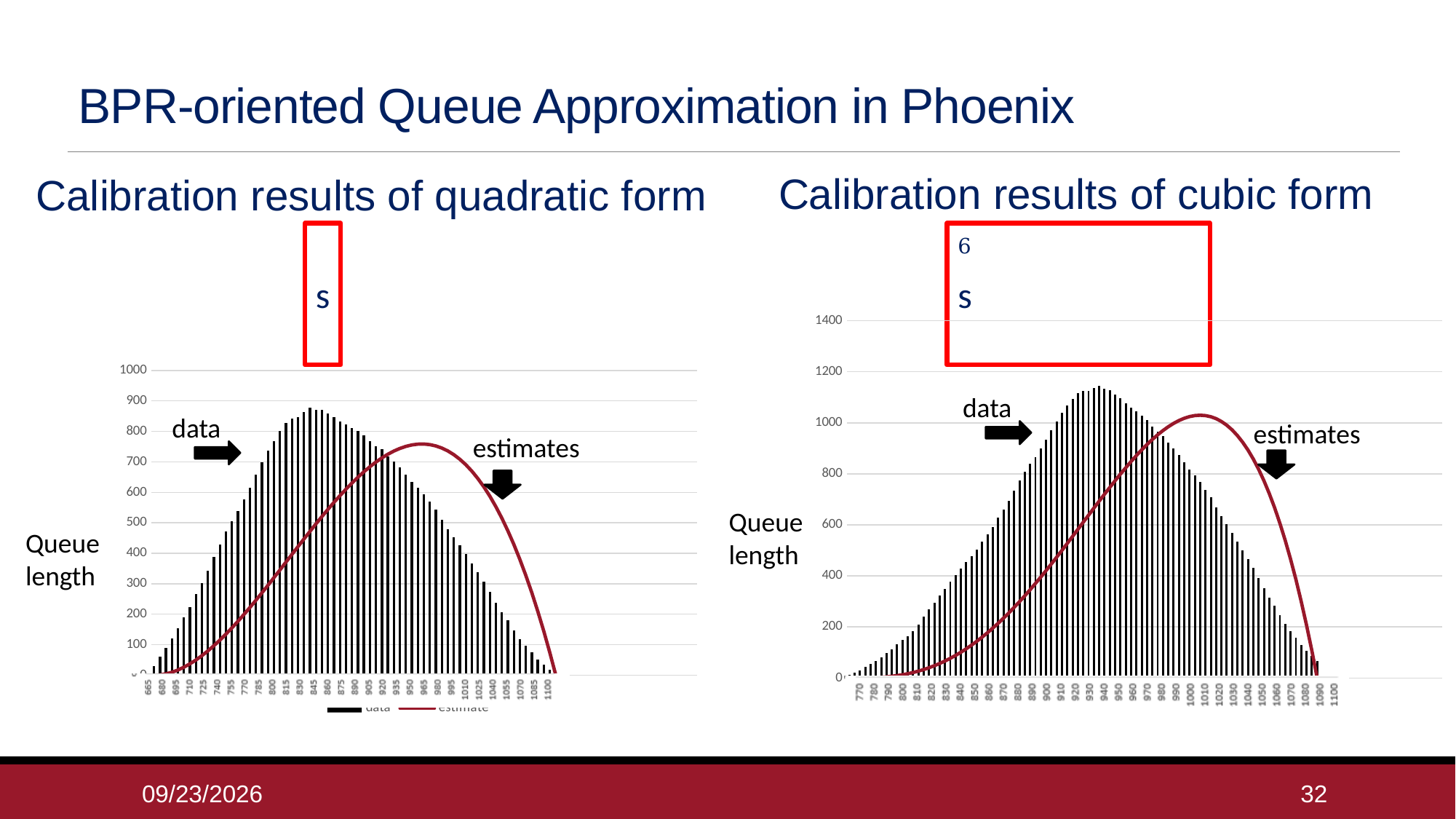
What kind of chart is the 'Calibration results of quadratic form' chart on the left? A bar chart with a line overlay In the 'Calibration results of cubic form' chart, is the peak of the estimate curve greater or less than 1200? less In the 'Calibration results of quadratic form' chart, how do the data bars change along the x axis? They rise to a peak and then fall In the 'Calibration results of quadratic form' chart, is the highest data bar greater or less than 800? greater In the 'Calibration results of cubic form' chart, is the highest data bar greater or less than 1000? greater What kind of chart is the 'Calibration results of cubic form' chart on the right? A bar chart with a line overlay What is the highest value shown on the y axis of the 'Calibration results of cubic form' chart? 1400 In the 'Calibration results of quadratic form' chart, which reaches a higher peak: the data bars or the estimate curve? The data bars In the 'Calibration results of quadratic form' chart, how many series does the legend list? 2 What is the y-axis label on both charts? Queue length In the 'Calibration results of cubic form' chart, which reaches a higher peak: the data bars or the estimate curve? The data bars